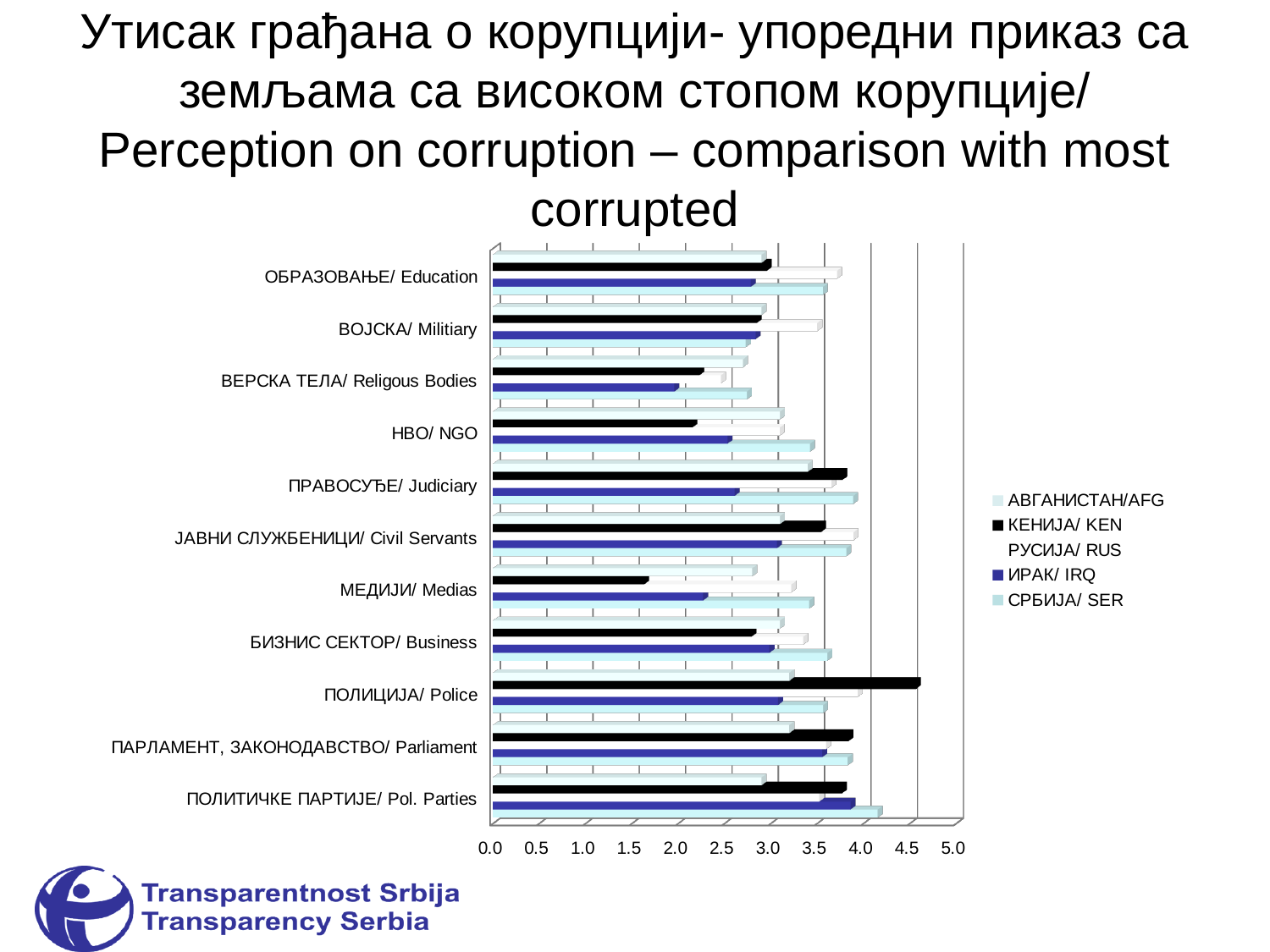
How many series does the legend list? 5 How many categories (institutions) are shown on the chart? 11 For the КЕНИЈА/ KEN series, which category has the highest value? ПОЛИЦИЈА/ Police Which legend entry is shown in black? КЕНИЈА/ KEN Is the КЕНИЈА/ KEN value for МЕДИЈИ/ Medias greater or less than 2.0? less Is the СРБИЈА/ SER value for ПОЛИТИЧКЕ ПАРТИЈЕ/ Pol. Parties greater or less than 3.5? greater For the ИРАК/ IRQ series, which category has the lowest value? ВЕРСКА ТЕЛА/ Religous Bodies Is the КЕНИЈА/ KEN value for ВЕРСКА ТЕЛА/ Religous Bodies greater or less than 3.0? less For the КЕНИЈА/ KEN series, which category has the lowest value? МЕДИЈИ/ Medias What kind of chart is shown on the slide? bar chart Which is larger for КЕНИЈА/ KEN: the value for ПРАВОСУЂЕ/ Judiciary or the value for НВО/ NGO? ПРАВОСУЂЕ/ Judiciary